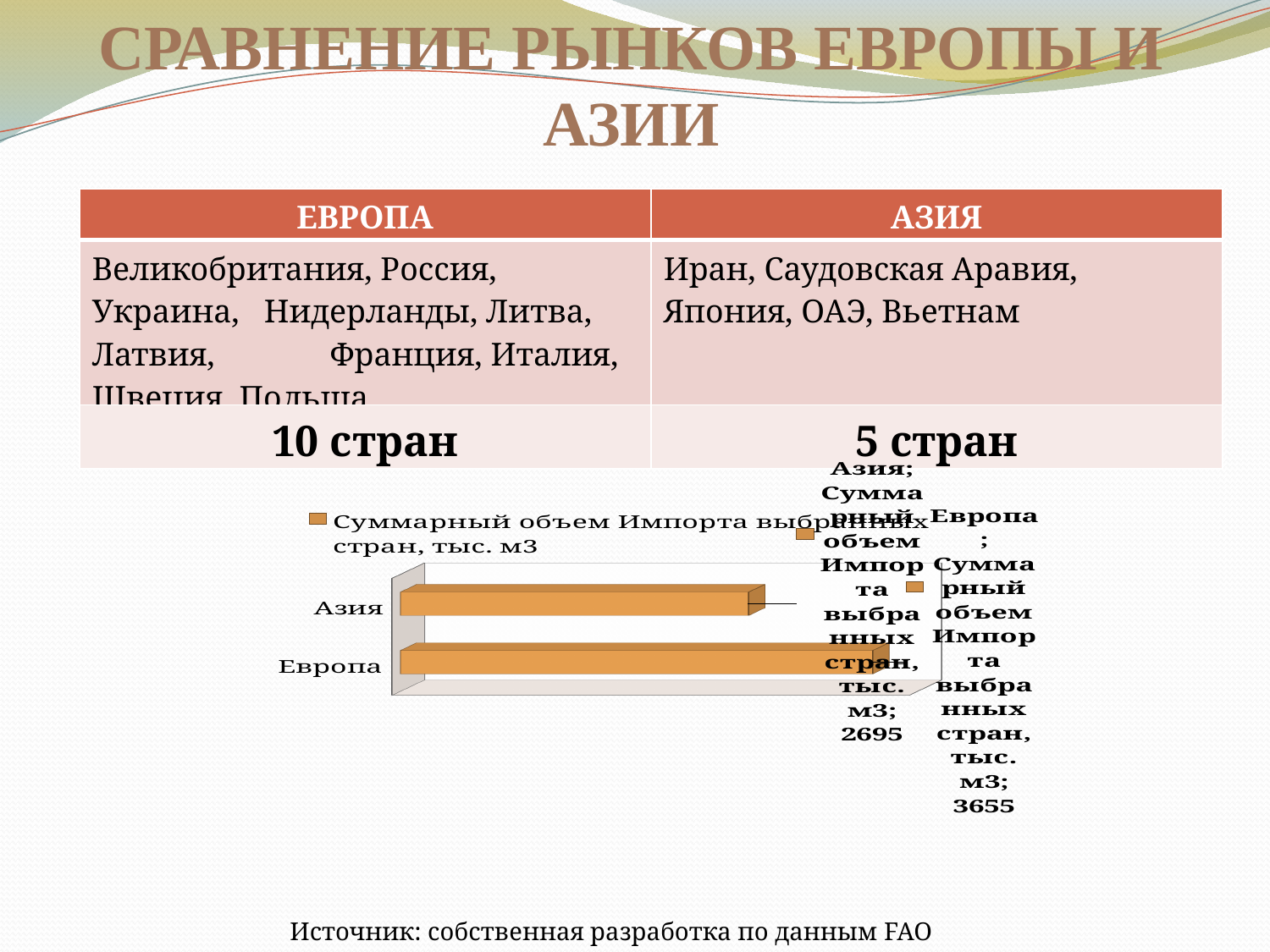
Which is larger, the value for Азия or the value for Европа? Европа What is the value for Европа in the chart? 3655 What type of chart is shown on the slide? bar chart Which category has the highest value in the chart? Европа What is the name of the series plotted in the chart? Суммарный объем Импорта выбранных стран, тыс. м3 What is the difference between the values for Европа and Азия? 960 What unit is used for the values in the chart, according to the series name? тыс. м3 Which category has the lowest value in the chart? Азия What is the value for Азия in the chart? 2695 How many categories are plotted in the chart? 2